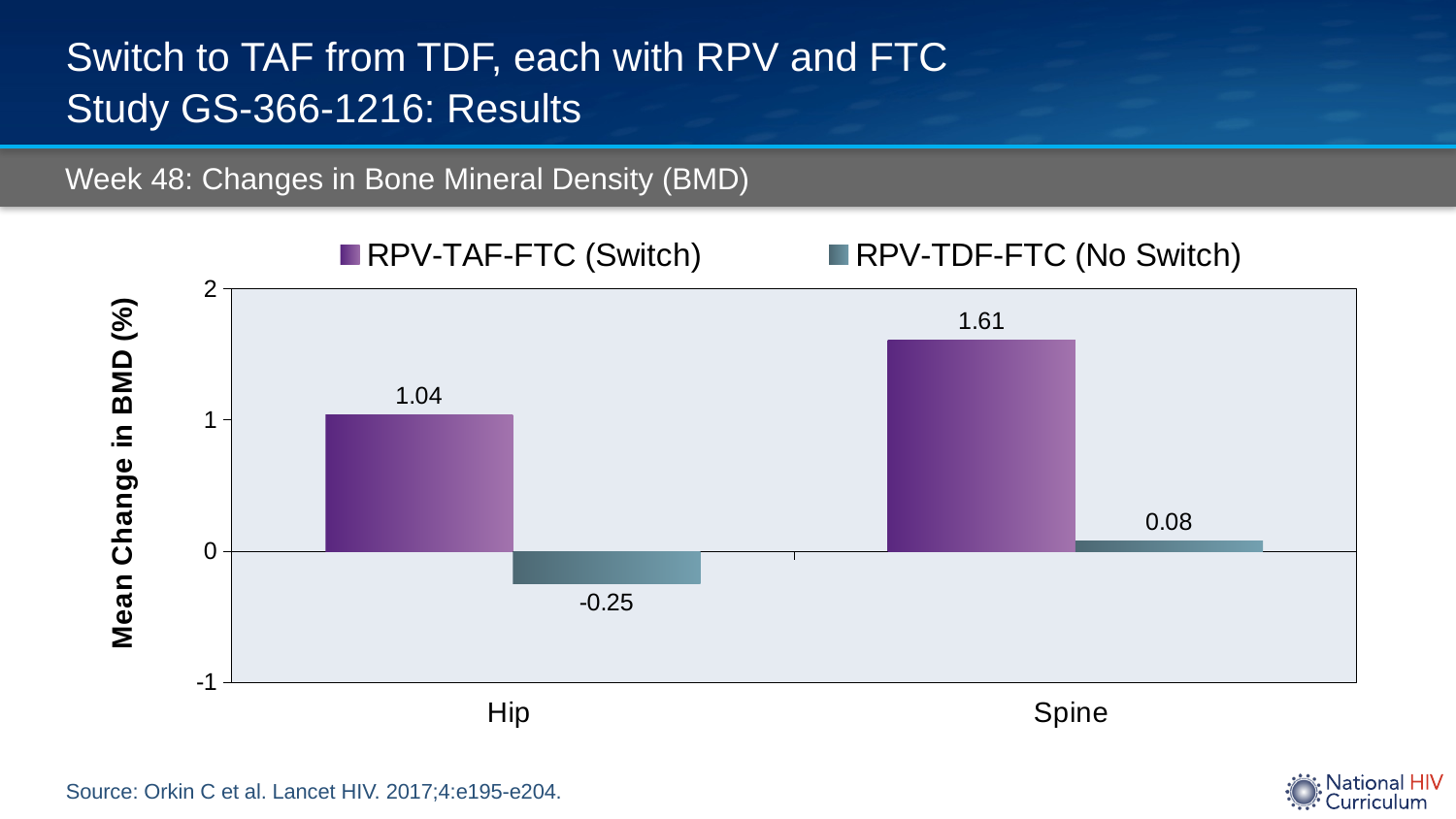
How many categories are shown on the x axis? 2 What is the mean change in BMD for RPV-TAF-FTC (Switch) at the Spine? 1.61 What is the mean change in BMD for RPV-TDF-FTC (No Switch) at the Hip? -0.25 What is the mean change in BMD for RPV-TAF-FTC (Switch) at the Hip? 1.04 What is the mean change in BMD for RPV-TDF-FTC (No Switch) at the Spine? 0.08 Which is larger for RPV-TAF-FTC (Switch): the Hip value or the Spine value? Spine What is the difference between the Switch and No Switch values at the Spine? 1.53 What is the difference between the Switch and No Switch values at the Hip? 1.29 What kind of chart is shown on the slide? Bar chart Which bar shows the highest mean change in BMD? RPV-TAF-FTC (Switch) at the Spine How many series does the legend list? 2 Which bar shows the lowest mean change in BMD? RPV-TDF-FTC (No Switch) at the Hip